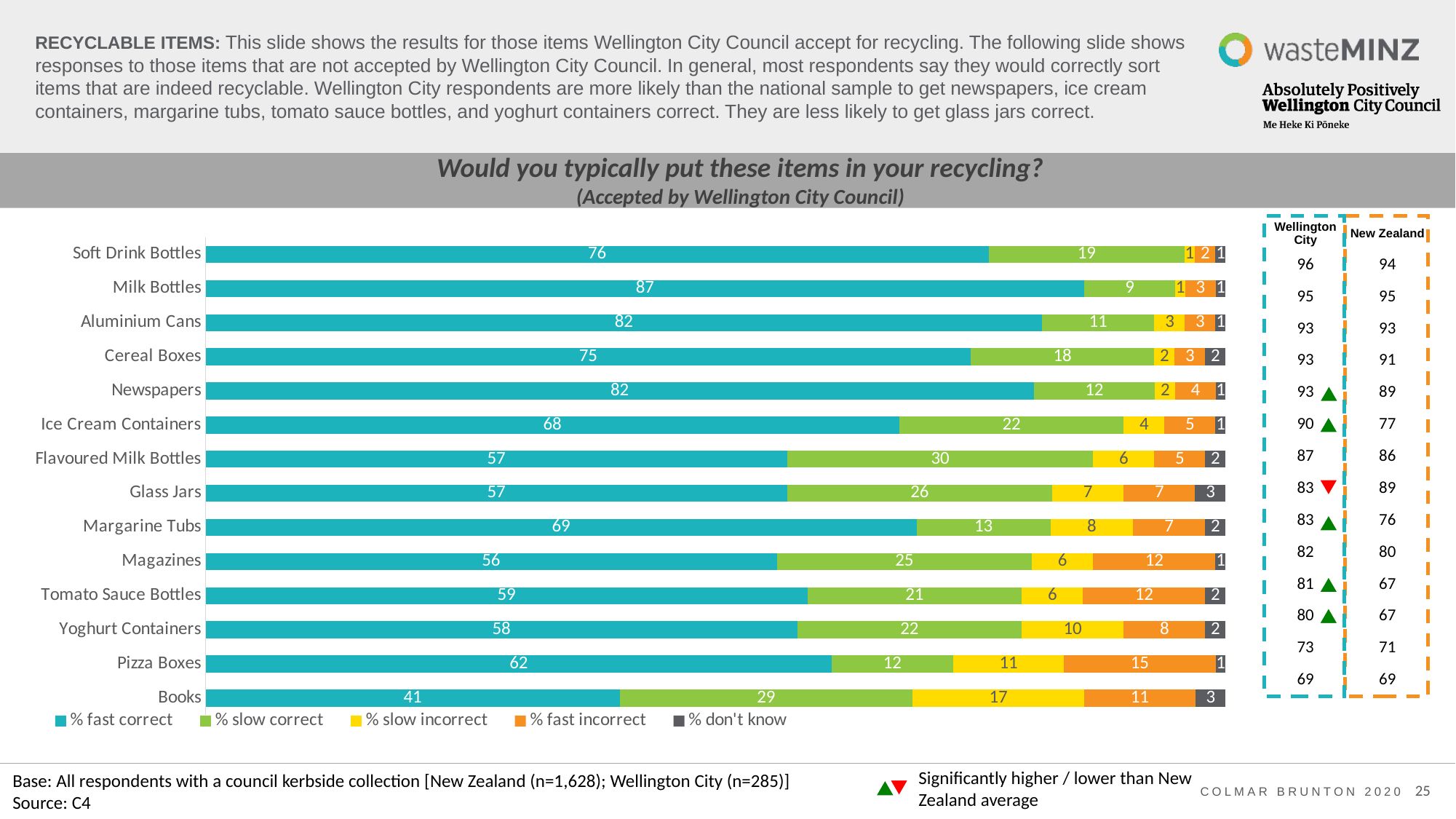
What is the '% fast incorrect' value for Pizza Boxes? 15 What is the '% slow correct' value for Flavoured Milk Bottles? 30 Which legend entry is shown in yellow? % slow incorrect What percentage of respondents are '% fast correct' for Milk Bottles? 87 What is the total of the stacked bar for Aluminium Cans? 100 How many items are listed on the chart? 14 Which has a larger '% slow incorrect' value, Books or Pizza Boxes? Books Which item has the lowest '% fast correct' value? Books Which item has the highest '% fast correct' value? Milk Bottles What is the difference between the '% fast correct' values for Soft Drink Bottles and Books? 35 What type of chart is shown on the slide? Stacked bar chart How many series does the legend list? 5